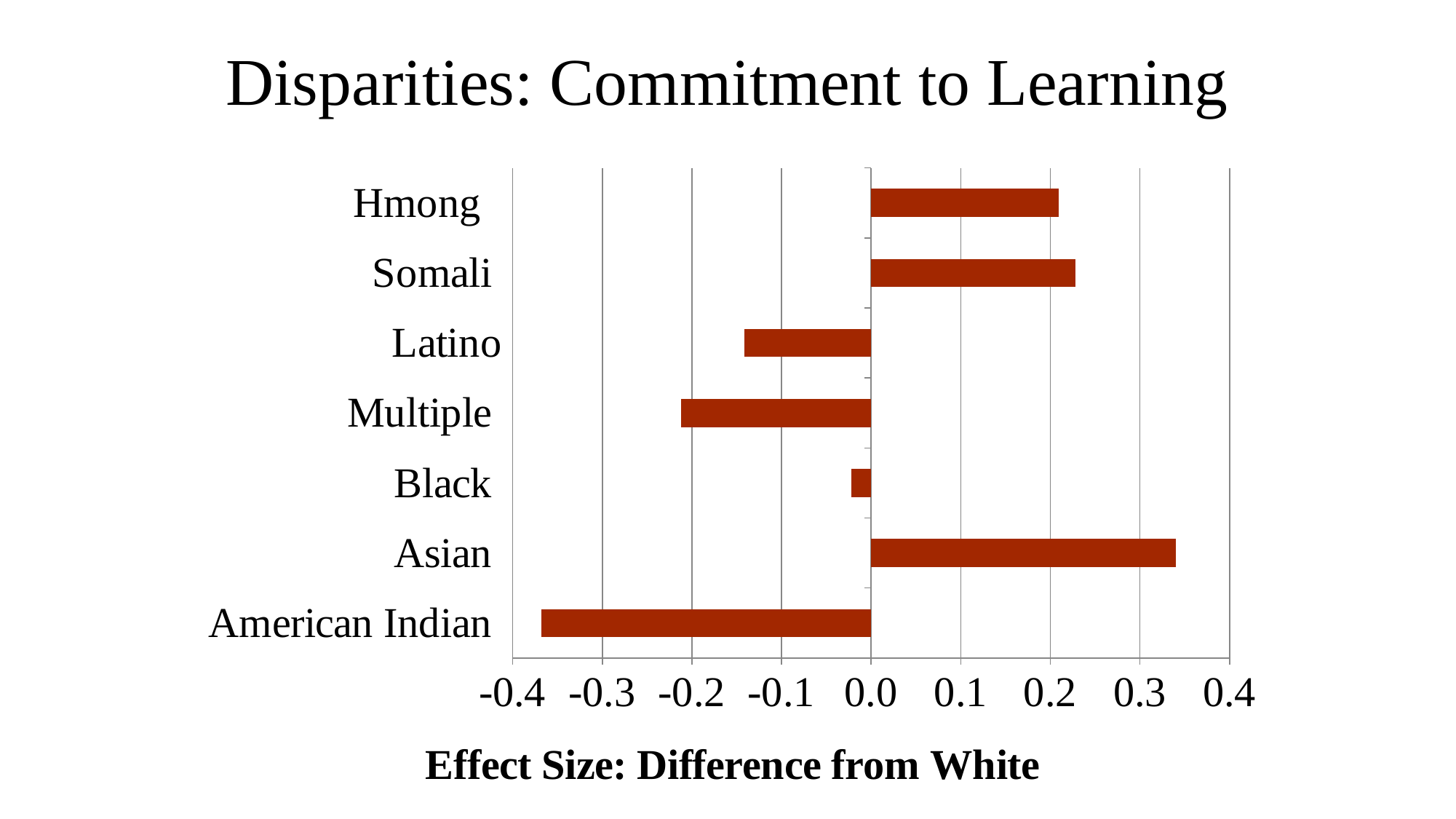
Which group has the highest effect size? Asian Is the value for Somali greater or less than 0.1? greater Which has the lower value, Multiple or Latino? Multiple Is the value for Multiple greater or less than -0.1? less How many groups are plotted in the chart? 7 How many groups have a positive effect size? 3 Is the value for Asian greater or less than 0.3? greater What kind of chart is shown on the slide? Bar chart Which group has the lowest effect size? American Indian Which has the larger value, Asian or Hmong? Asian